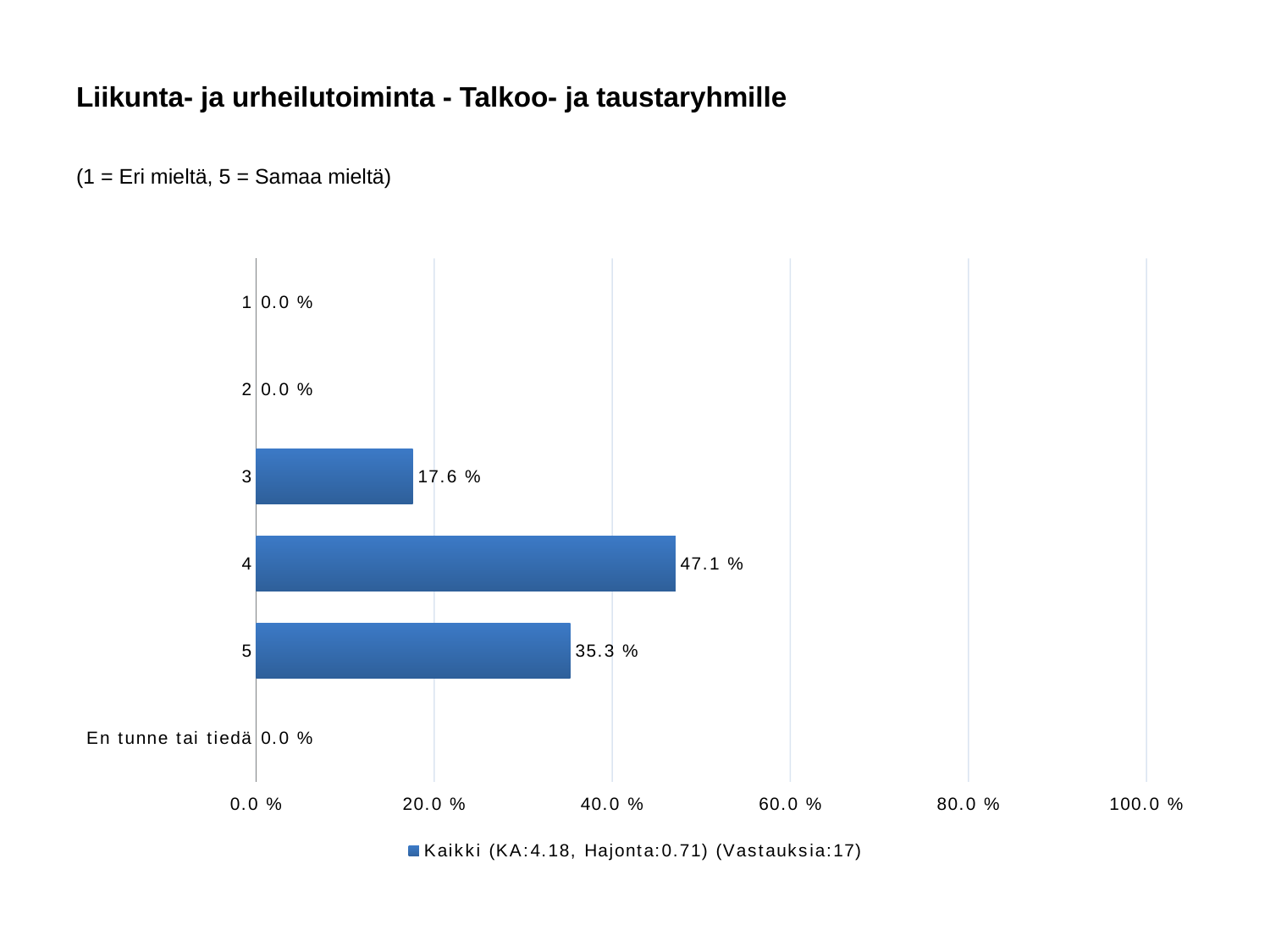
What is the value for category 5? 35.3 % What is the value for the category 'En tunne tai tiedä'? 0.0 % Which category has the highest value? 4 Is the value for category 4 greater or less than 40.0 %? greater How many series does the legend list? 1 What is the difference between the values for category 4 and category 5? 11.8 % What is the value for category 4? 47.1 % What is the value for category 3? 17.6 % What kind of chart is shown on the slide? bar chart Which is larger, the value for category 3 or the value for category 5? 5 How many categories are shown on the chart? 6 What is the legend entry for the series? Kaikki (KA:4.18, Hajonta:0.71) (Vastauksia:17)